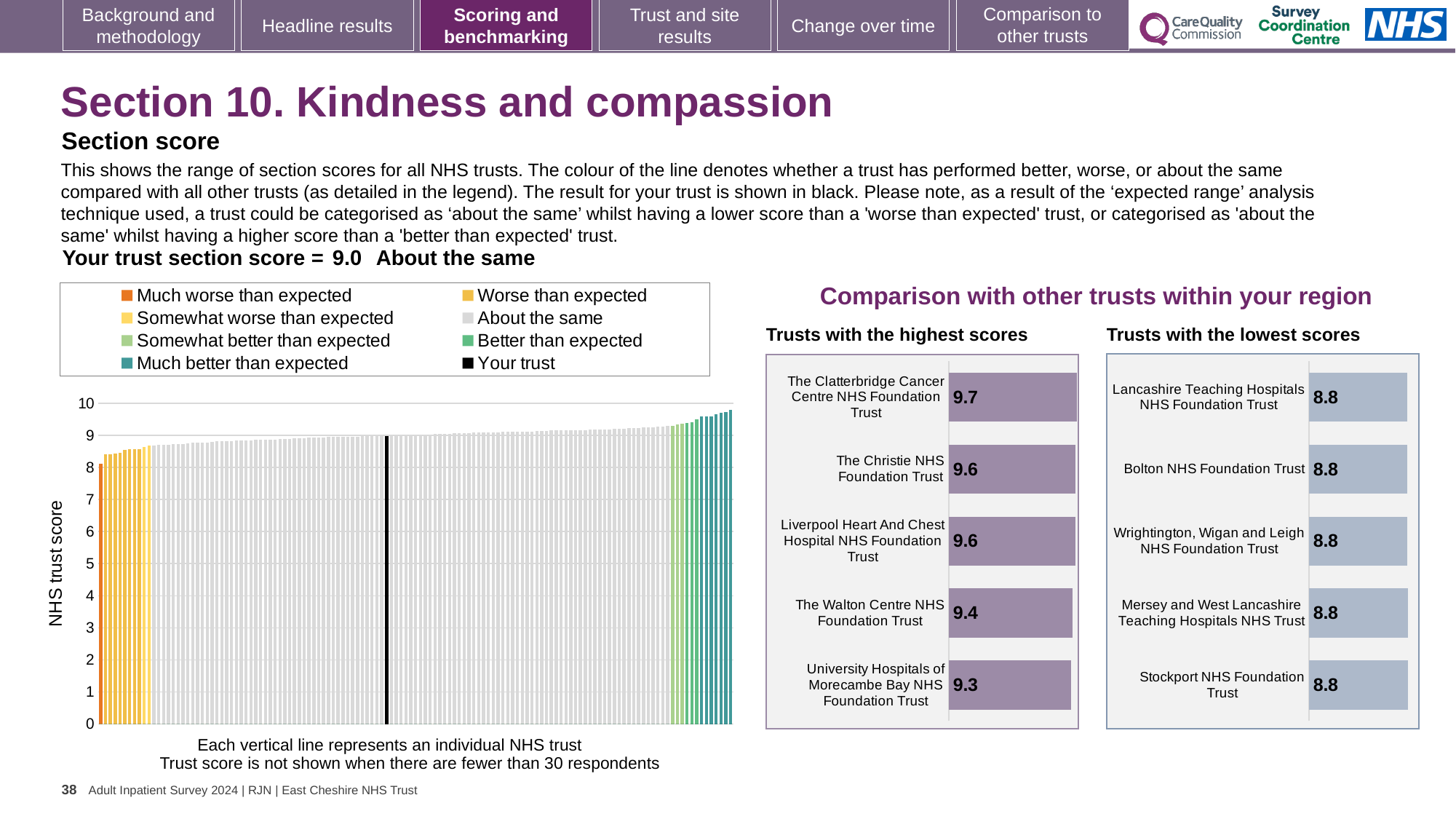
In the 'Trusts with the highest scores' chart, which trust has the lowest score? University Hospitals of Morecambe Bay NHS Foundation Trust Which is larger: the score for The Christie NHS Foundation Trust in the 'Trusts with the highest scores' chart or the score for Bolton NHS Foundation Trust in the 'Trusts with the lowest scores' chart? The Christie NHS Foundation Trust In the large chart on the left showing all NHS trusts, what is the section score for your trust (the black bar)? 9.0 In the 'Trusts with the highest scores' chart, what is the score for The Clatterbridge Cancer Centre NHS Foundation Trust? 9.7 In the 'Trusts with the highest scores' chart, what is the difference between the scores of The Clatterbridge Cancer Centre NHS Foundation Trust and University Hospitals of Morecambe Bay NHS Foundation Trust? 0.4 How many entries does the legend of the large chart on the left list? 8 In the large chart on the left showing all NHS trusts, do the bar values rise or fall from left to right? rise What kind of chart is the large chart on the left showing all NHS trusts? bar chart In the 'Trusts with the lowest scores' chart, how many trusts are shown? 5 In the 'Trusts with the highest scores' chart, which trust has the highest score? The Clatterbridge Cancer Centre NHS Foundation Trust In the 'Trusts with the highest scores' chart, how many trusts are shown? 5 In the 'Trusts with the lowest scores' chart, what is the score for Stockport NHS Foundation Trust? 8.8